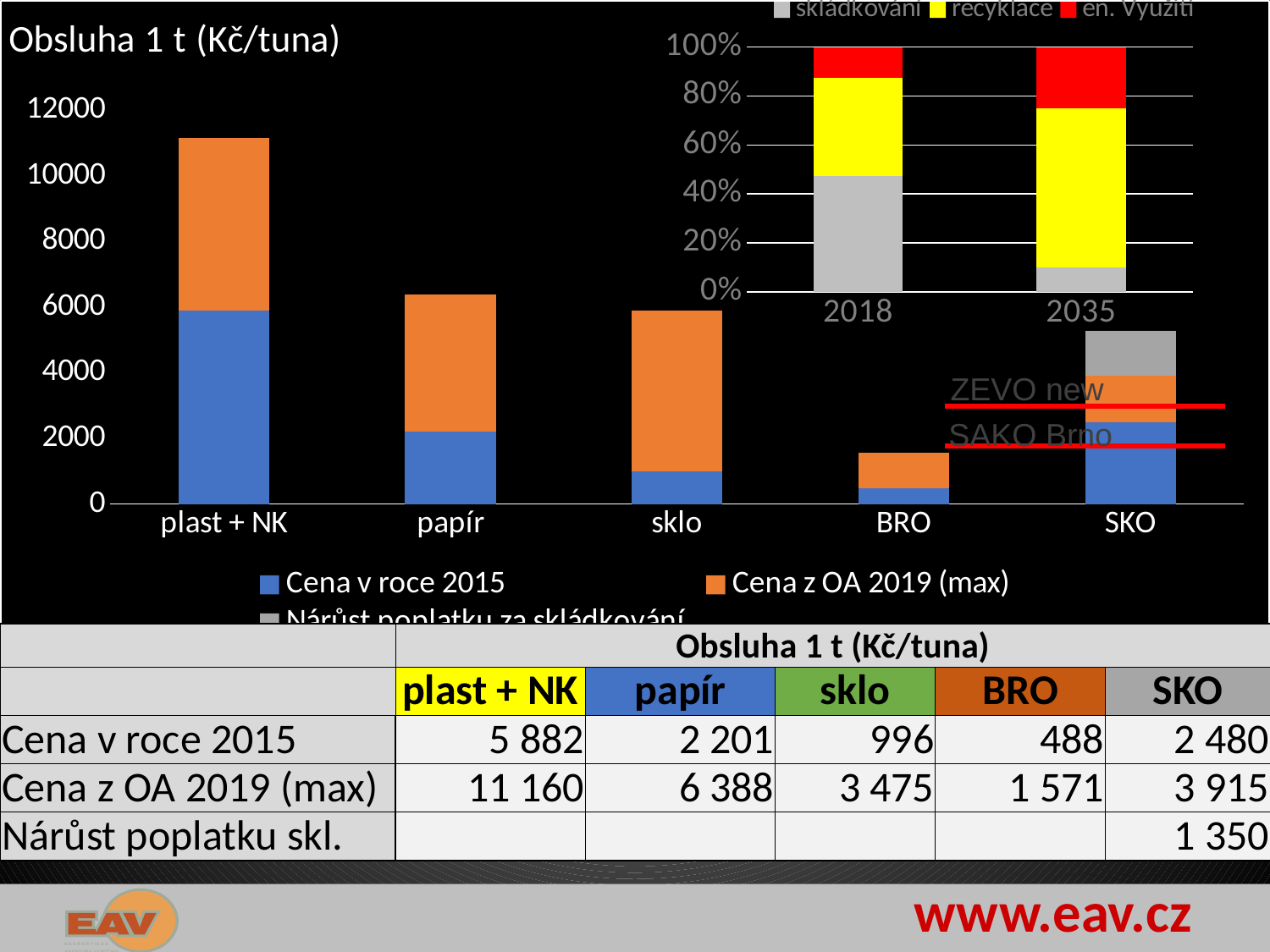
On the small stacked chart in the top right, is the 'skládkování' share for 2018 greater or less than 40%? greater On the 'Obsluha 1 t (Kč/tuna)' bar chart, which category has the tallest bar? plast + NK What kind of chart is the 'Obsluha 1 t (Kč/tuna)' chart? bar chart On the 'Obsluha 1 t (Kč/tuna)' bar chart, what is the value of 'Nárůst poplatku' for SKO? 1 350 How many series does the legend of the small stacked chart in the top right list? 3 How many categories are shown on the x axis of the 'Obsluha 1 t (Kč/tuna)' bar chart? 5 On the 'Obsluha 1 t (Kč/tuna)' bar chart, which category has the lowest 'Cena v roce 2015' value? BRO On the small stacked chart in the top right, is the 'skládkování' share for 2035 greater or less than 20%? less On the 'Obsluha 1 t (Kč/tuna)' bar chart, what is the difference between 'Cena z OA 2019 (max)' and 'Cena v roce 2015' for papír? 4 187 On the 'Obsluha 1 t (Kč/tuna)' bar chart, what is the value of 'Cena v roce 2015' for plast + NK? 5 882